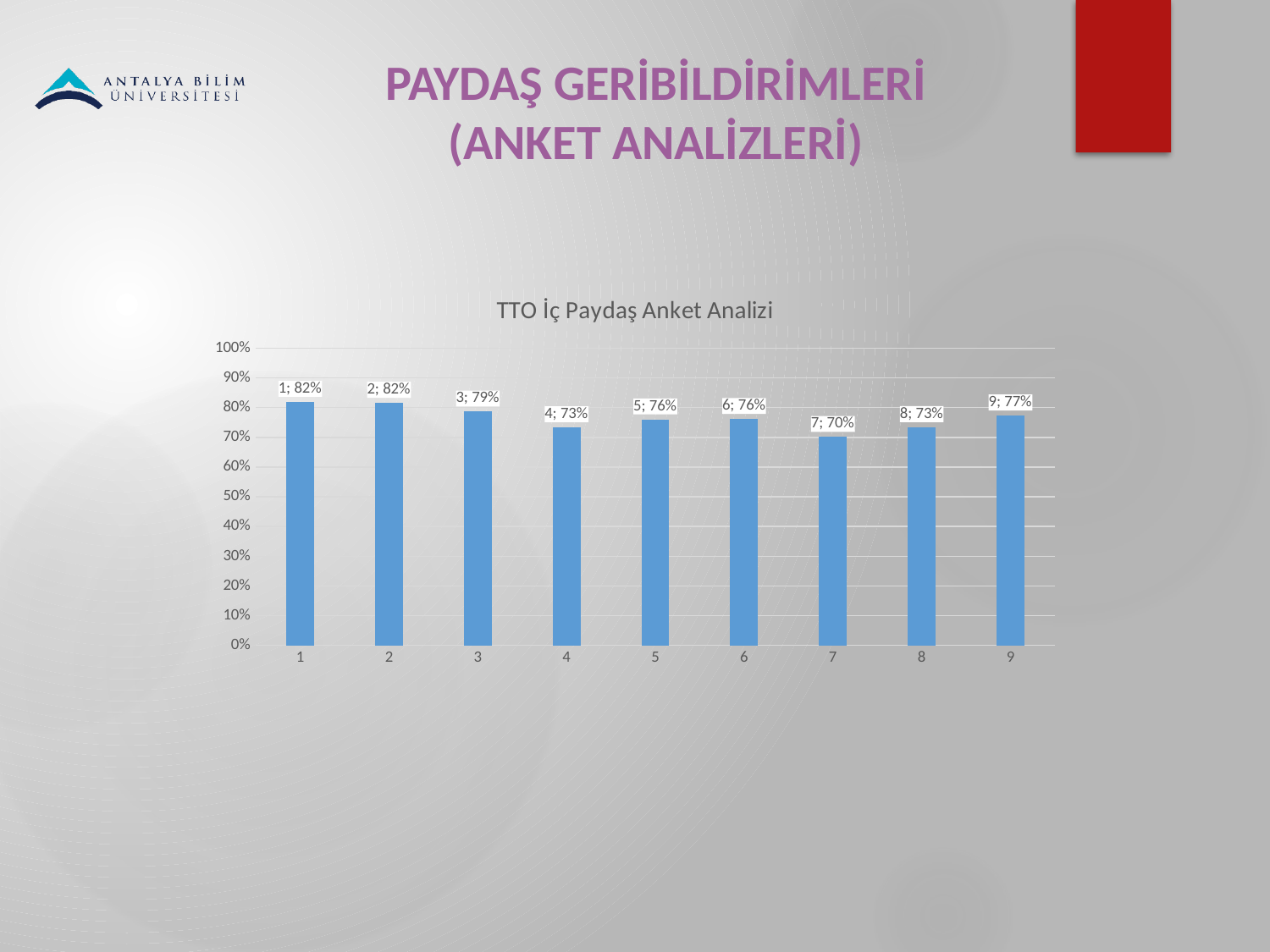
What kind of chart is shown on the slide? Bar chart What is the value for category 7? 70% What is the difference between the values for category 1 and category 7? 12% What is the value for category 4? 73% Which category has the lowest value? 7 Is the value for category 5 greater or less than 80%? less What is the title of the chart? TTO İç Paydaş Anket Analizi What is the value for category 1? 82% How many categories are shown on the x axis? 9 What is the difference between the values for category 6 and category 8? 3% Which is larger, the value for category 3 or the value for category 4? Category 3 What is the value for category 9? 77%